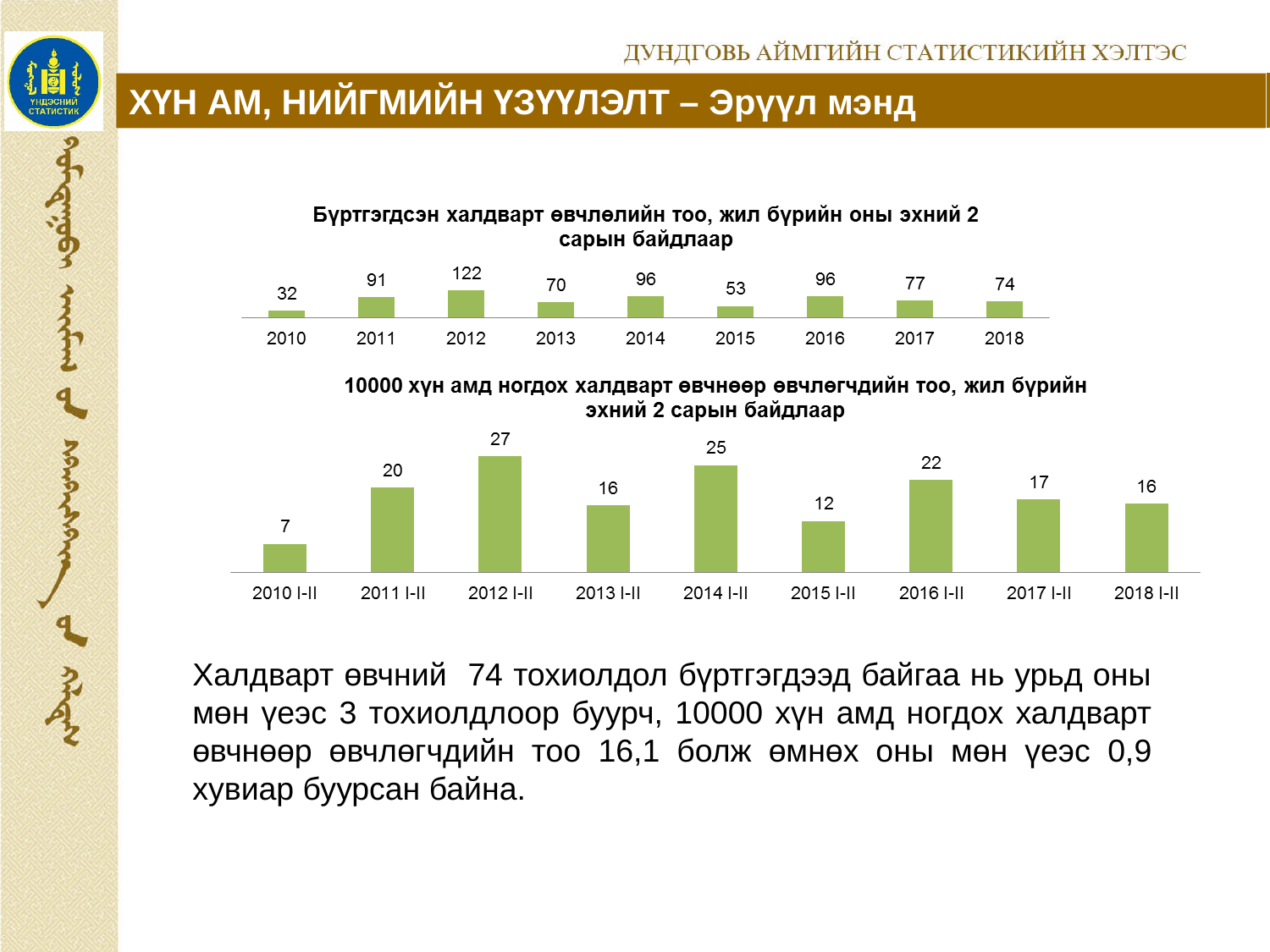
In the top chart (Бүртгэгдсэн халдварт өвчлөлийн тоо), which year has the lowest value? 2010 What kind of chart is the bottom chart (10000 хүн амд ногдох халдварт өвчнөөр өвчлөгчдийн тоо)? Bar chart In the bottom chart (10000 хүн амд ногдох халдварт өвчнөөр өвчлөгчдийн тоо), which period has the highest value? 2012 I-II In the bottom chart (10000 хүн амд ногдох халдварт өвчнөөр өвчлөгчдийн тоо), which is larger, the value for 2011 I-II or the value for 2017 I-II? 2011 I-II In the bottom chart (10000 хүн амд ногдох халдварт өвчнөөр өвчлөгчдийн тоо), what is the difference between the values for 2016 I-II and 2015 I-II? 10 In the top chart (Бүртгэгдсэн халдварт өвчлөлийн тоо), which is larger, the value for 2013 or the value for 2015? 2013 In the top chart (Бүртгэгдсэн халдварт өвчлөлийн тоо), do the values rise or fall from 2016 to 2018? Fall In the bottom chart (10000 хүн амд ногдох халдварт өвчнөөр өвчлөгчдийн тоо), which period has the lowest value? 2010 I-II In the top chart (Бүртгэгдсэн халдварт өвчлөлийн тоо), what is the value for 2012? 122 In the top chart (Бүртгэгдсэн халдварт өвчлөлийн тоо), how many years are shown? 9 In the top chart (Бүртгэгдсэн халдварт өвчлөлийн тоо), what is the difference between the values for 2017 and 2018? 3 In the bottom chart (10000 хүн амд ногдох халдварт өвчнөөр өвчлөгчдийн тоо), what is the value for 2014 I-II? 25